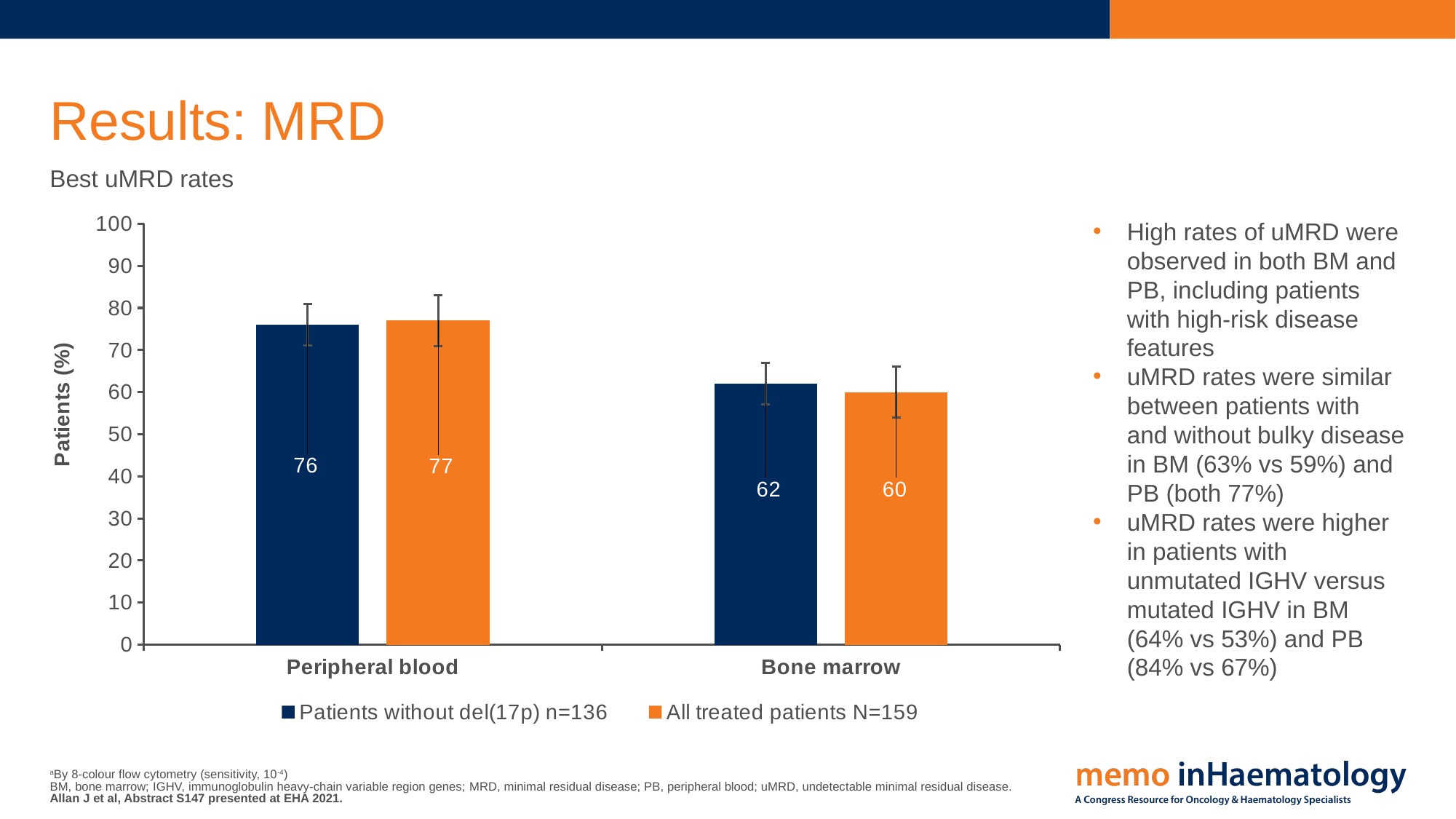
What is the uMRD rate for all treated patients in peripheral blood? 77 What is the uMRD rate for all treated patients in bone marrow? 60 Which bar shows the highest value on the chart? All treated patients N=159, Peripheral blood Which is larger: the peripheral blood value for patients without del(17p) or the bone marrow value for patients without del(17p)? Peripheral blood What is the difference between the peripheral blood and bone marrow values for patients without del(17p)? 14 Which bar shows the lowest value on the chart? All treated patients N=159, Bone marrow What type of chart is shown on the slide? Bar chart What is the uMRD rate for patients without del(17p) in peripheral blood? 76 What is the uMRD rate for patients without del(17p) in bone marrow? 62 How many series does the legend list? 2 What is the difference between the peripheral blood and bone marrow values for all treated patients? 17 How many categories are shown on the x axis? 2